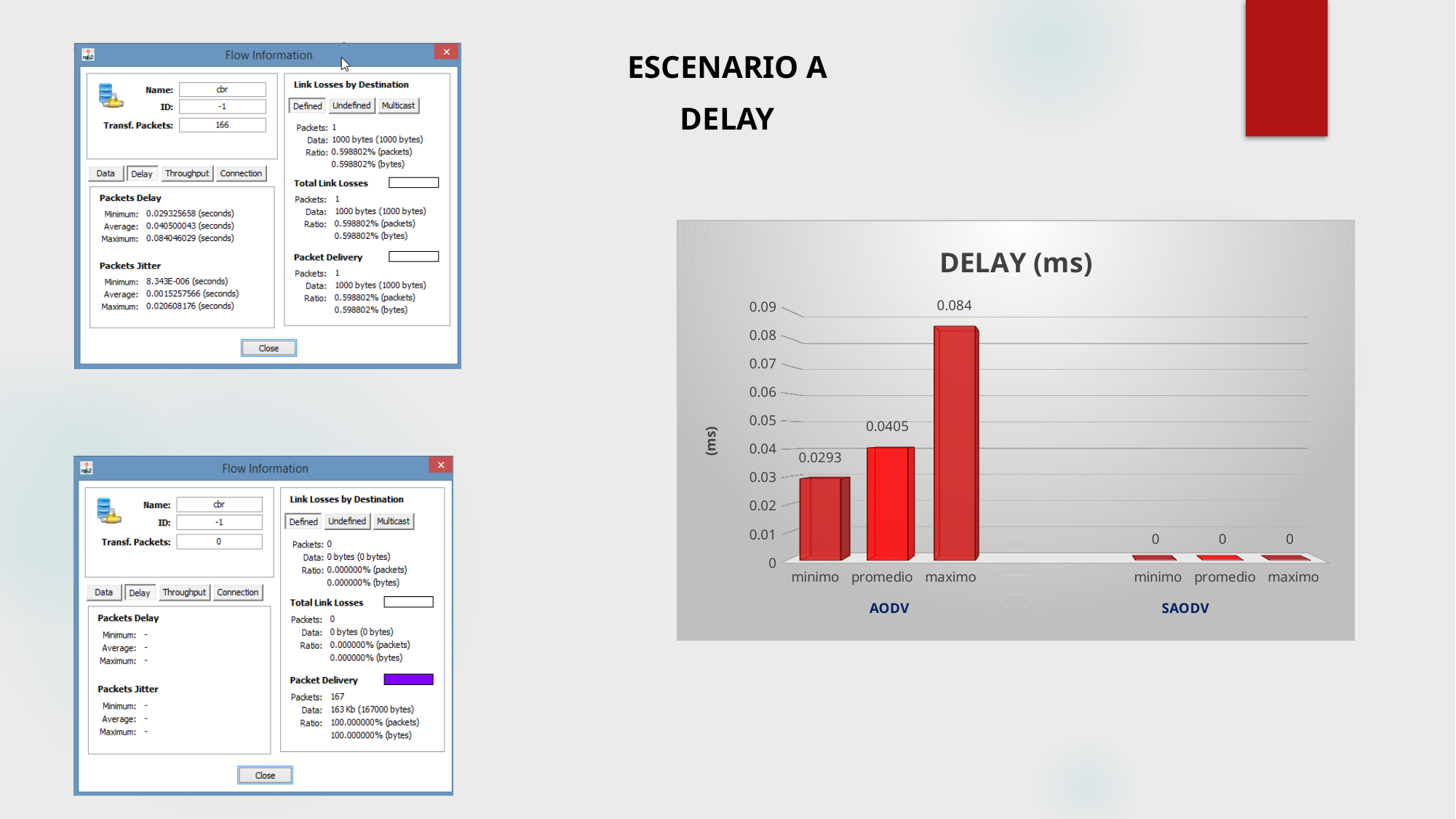
What kind of chart is the DELAY (ms) chart? bar chart How many bars are plotted in the DELAY (ms) chart? 6 What is the difference between the AODV maximo and AODV minimo values in the DELAY (ms) chart? 0.0547 Which bar is the highest in the DELAY (ms) chart? AODV maximo What is the value of the AODV minimo bar in the DELAY (ms) chart? 0.0293 What is the value of the AODV promedio bar in the DELAY (ms) chart? 0.0405 Which is larger in the DELAY (ms) chart, AODV promedio or SAODV promedio? AODV promedio What is the difference between the AODV promedio and AODV minimo values in the DELAY (ms) chart? 0.0112 What is the label on the vertical axis of the DELAY (ms) chart? (ms) What is the value of the AODV maximo bar in the DELAY (ms) chart? 0.084 What is the value of the SAODV promedio bar in the DELAY (ms) chart? 0 Is the AODV maximo value in the DELAY (ms) chart greater or less than 0.05? greater